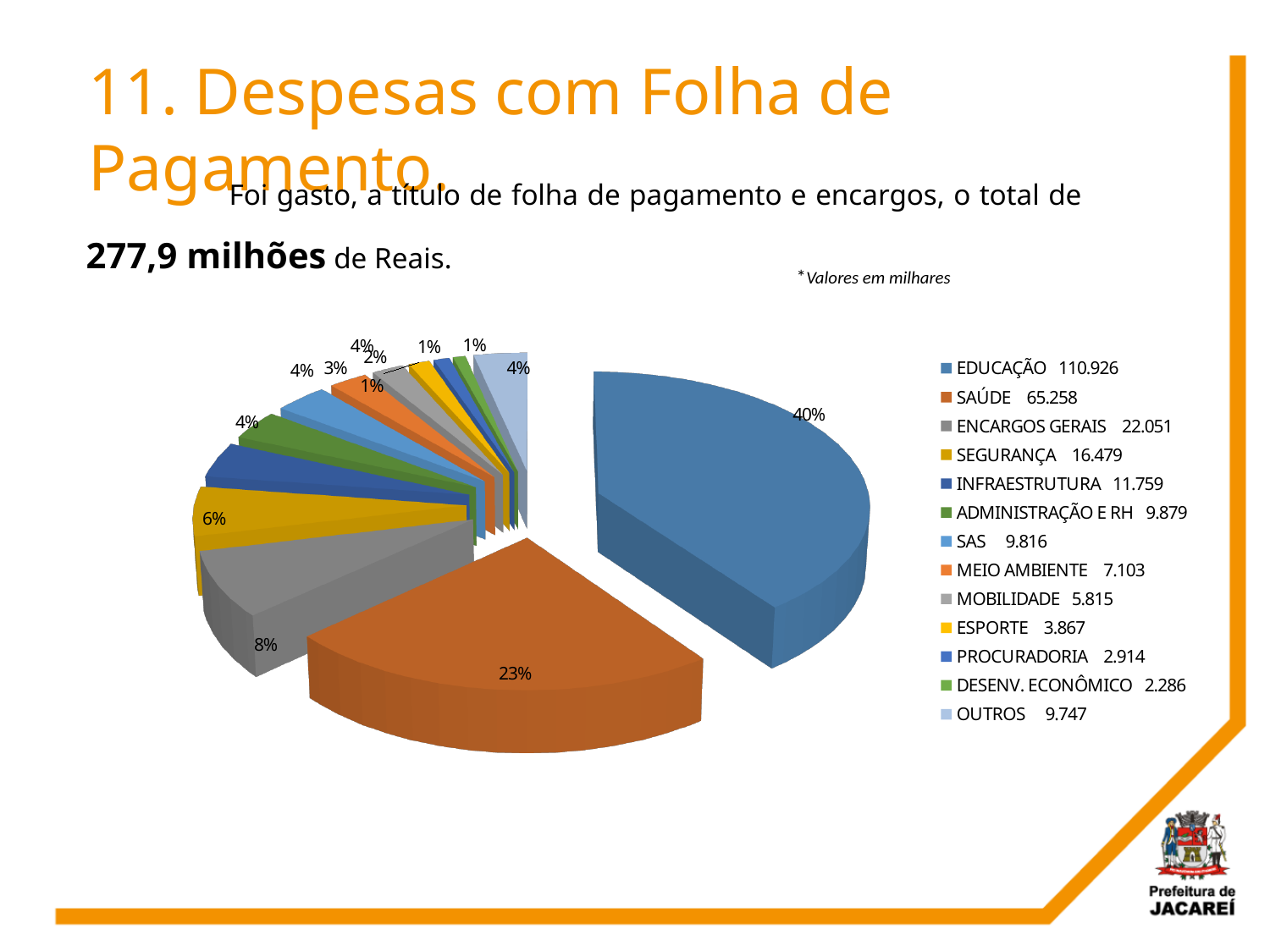
What share of the pie does ENCARGOS GERAIS represent? 8% How many categories does the pie chart's legend list? 13 What is the value shown for SAÚDE in the legend? 65.258 What is the value shown for OUTROS in the legend? 9.747 Which category has the smallest value in the legend? DESENV. ECONÔMICO What is the difference between the legend values for EDUCAÇÃO and SAÚDE? 45.668 What share of the pie does SAÚDE represent? 23% What is the value shown for EDUCAÇÃO in the legend? 110.926 What share of the pie does EDUCAÇÃO represent? 40% Which category has the largest slice of the pie? EDUCAÇÃO Which is larger, the value for ENCARGOS GERAIS or the value for SEGURANÇA? ENCARGOS GERAIS What kind of chart is shown on the slide? pie chart